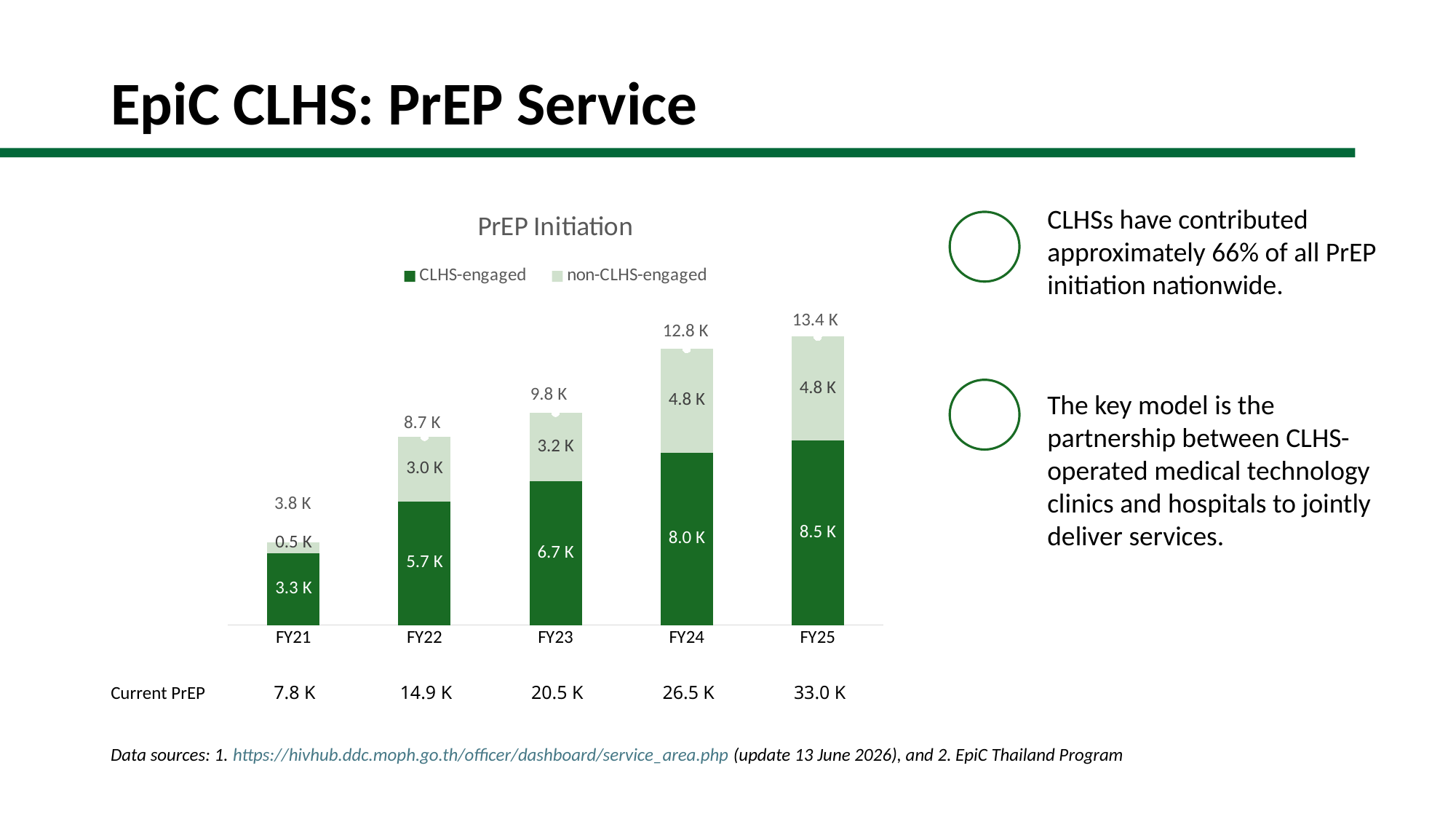
What kind of chart is shown on the slide? Stacked bar chart Which is larger, the CLHS-engaged value for FY22 or for FY23? FY23 What is the CLHS-engaged value for FY23? 6.7 K What is the non-CLHS-engaged value for FY22? 3.0 K Which fiscal year has the highest CLHS-engaged value? FY25 Which fiscal year has the lowest non-CLHS-engaged value? FY21 How many series does the chart legend list? 2 What is the difference between the CLHS-engaged values for FY25 and FY21? 5.2 K What is the total PrEP initiation shown for FY24? 12.8 K Do the total PrEP initiation values rise or fall from FY21 to FY25? Rise What is the title of the chart? PrEP Initiation How many fiscal years are shown on the x axis of the chart? 5